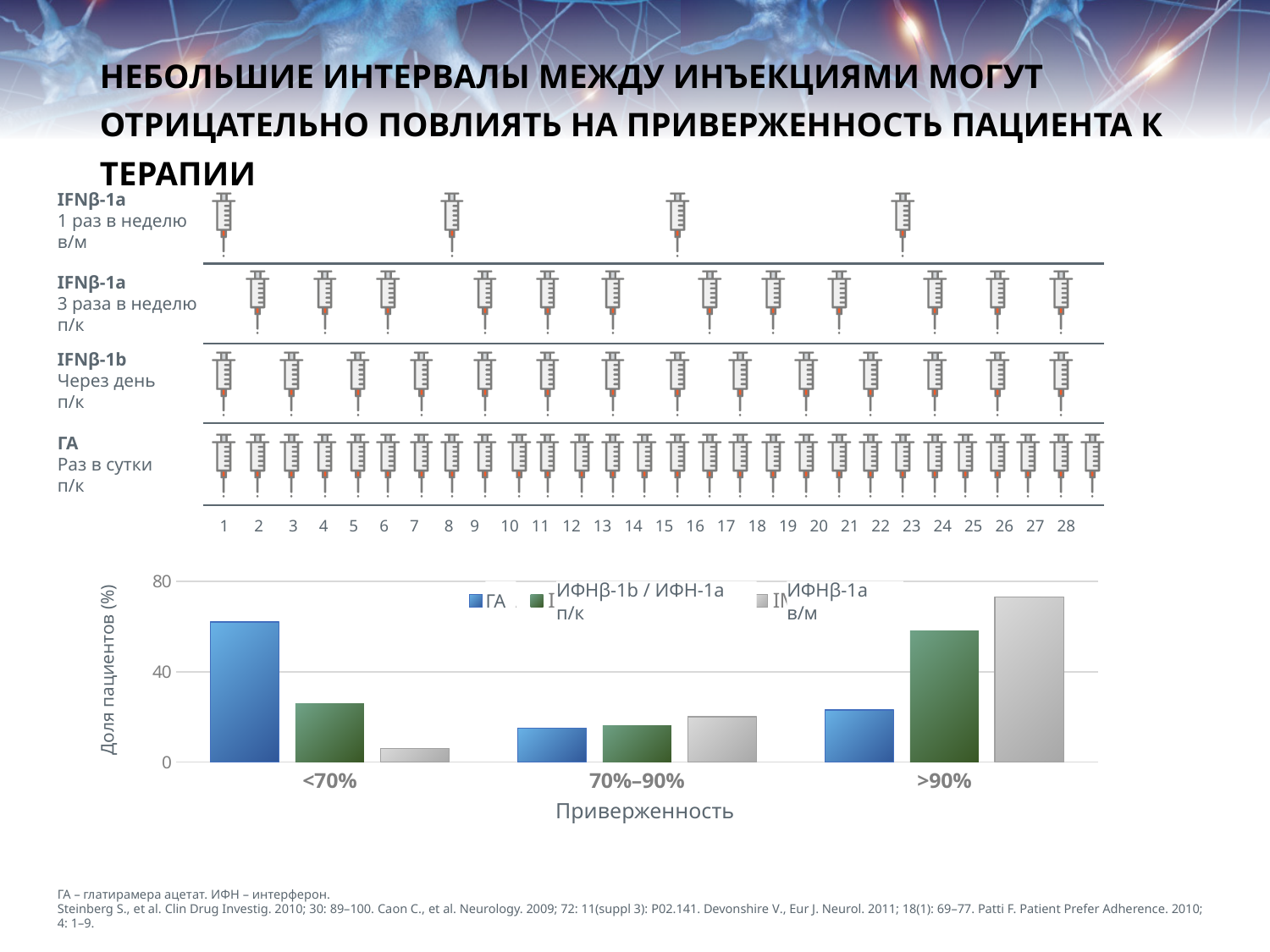
Which series has the lowest value in the >90% adherence category? ГА Do the values for ИФНβ-1a в/м rise or fall from the <70% category to the >90% category? rise Is the value for ИФНβ-1a в/м in the <70% category greater or less than 40? less Is the value for ИФНβ-1a в/м in the >90% category greater or less than 40? greater Which series has the highest value in the <70% adherence category? ГА What is the title of the y axis of the bar chart? Доля пациентов (%) What kind of chart is shown at the bottom of the slide? bar chart Is the value for ГА in the <70% category greater or less than 40? greater In the >90% category, which is larger: the value for ГА or the value for ИФНβ-1b / ИФН-1a п/к? ИФНβ-1b / ИФН-1a п/к Which series has the highest value in the >90% adherence category? ИФНβ-1a в/м How many adherence categories are shown on the x axis of the bar chart? 3 How many series does the legend of the bar chart list? 3